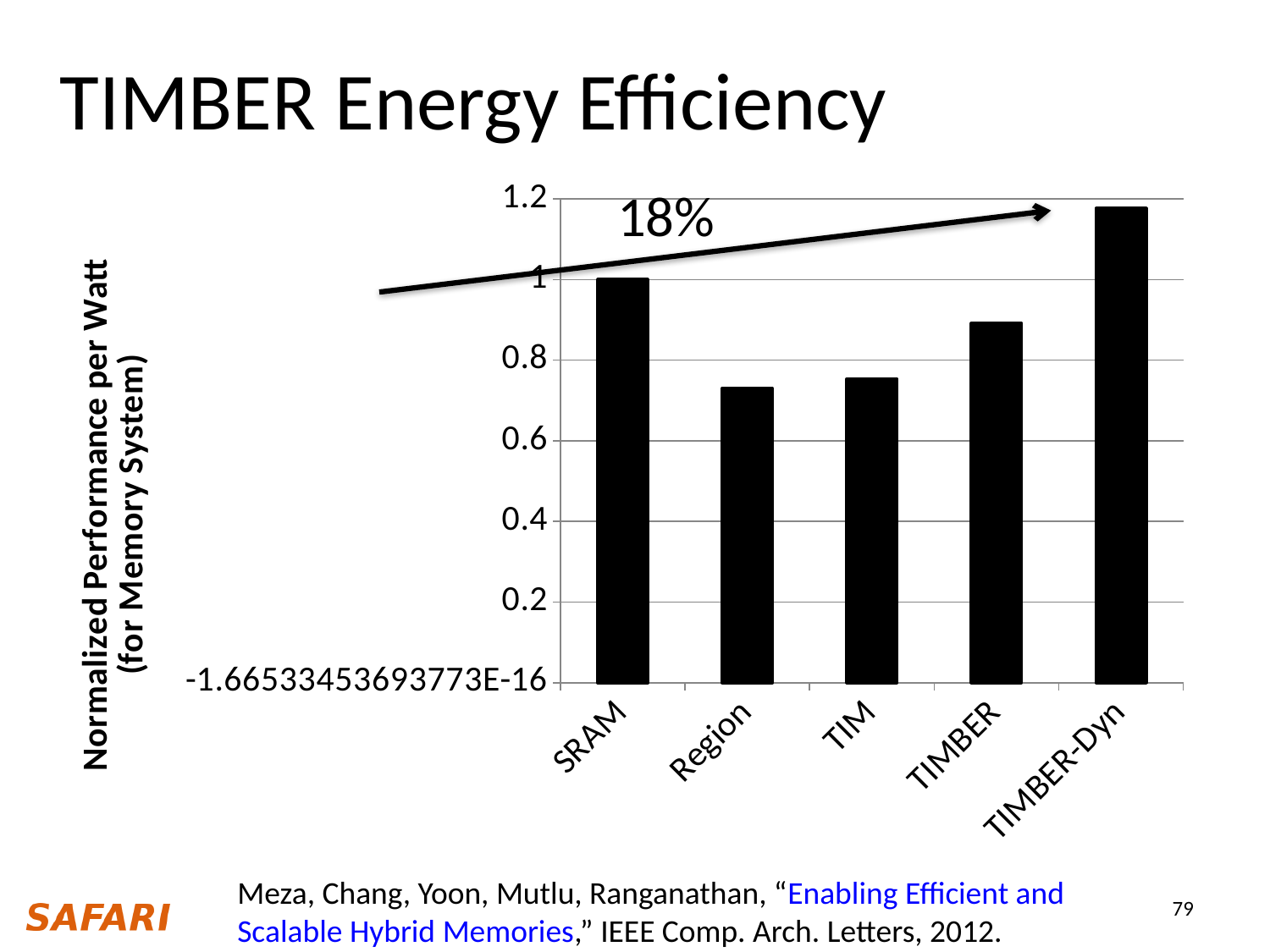
Is the value for Region greater or less than 0.8? less Which category has the highest normalized performance per watt? TIMBER-Dyn What kind of chart is shown on the slide? bar chart What is the label of the y axis? Normalized Performance per Watt (for Memory System) How many categories are plotted on the x axis? 5 Which has a larger value, TIMBER or TIM? TIMBER Is the value for TIMBER greater or less than 1? less Which has a larger value, TIMBER-Dyn or SRAM? TIMBER-Dyn Is the value for TIMBER-Dyn greater or less than 1? greater What is the normalized performance per watt for SRAM? 1 What percentage is written next to the arrow annotation on the chart? 18%